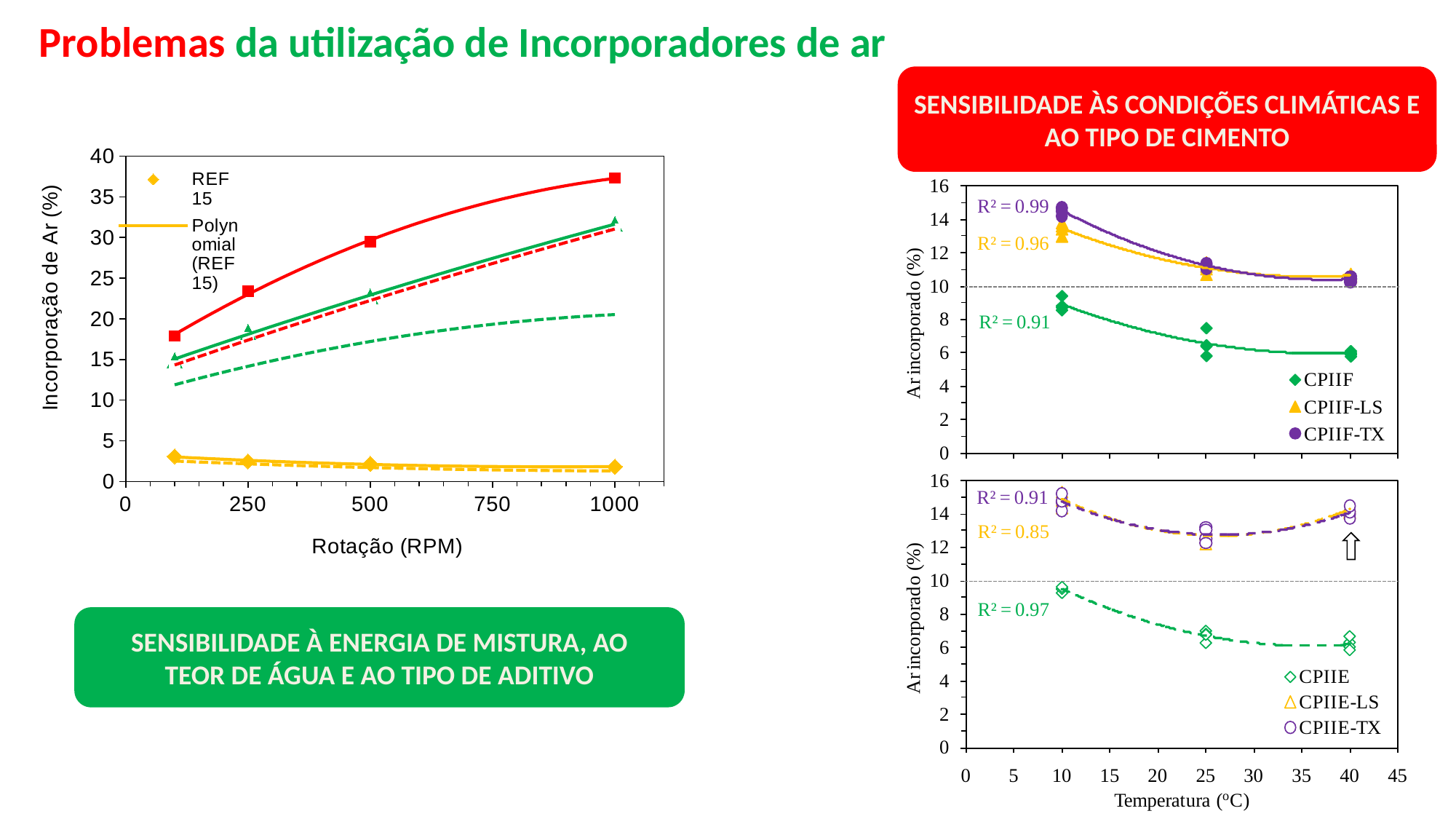
On the left chart (Rotação (RPM)), is the value of the red square series at 1000 RPM greater or less than 35? greater On the top-right chart (CPIIF series), is the value for CPIIF at 40 °C greater or less than 8? less On the left chart (Rotação (RPM)), is the value for REF 15 at 1000 RPM greater or less than 5? less On the left chart (Rotação (RPM)), does the REF 15 series rise or fall as rotation increases? fall On the left chart (Rotação (RPM)), what kind of chart is it? line chart On the bottom-right chart (CPIIE series), does the CPIIE series rise or fall as temperature increases? fall On the left chart (Rotação (RPM)), what is the label of the y axis? Incorporação de Ar (%) On the left chart (Rotação (RPM)), does the red square series rise or fall as rotation increases? rise On the bottom-right chart (CPIIE series), what is the R² value shown for the CPIIE-LS fit? 0.85 On the top-right chart (CPIIF series), how many series does the legend list? 3 On the top-right chart (CPIIF series), what is the R² value shown for the CPIIF-TX fit? 0.99 On the top-right chart (CPIIF series), which series has the lowest R² value? CPIIF